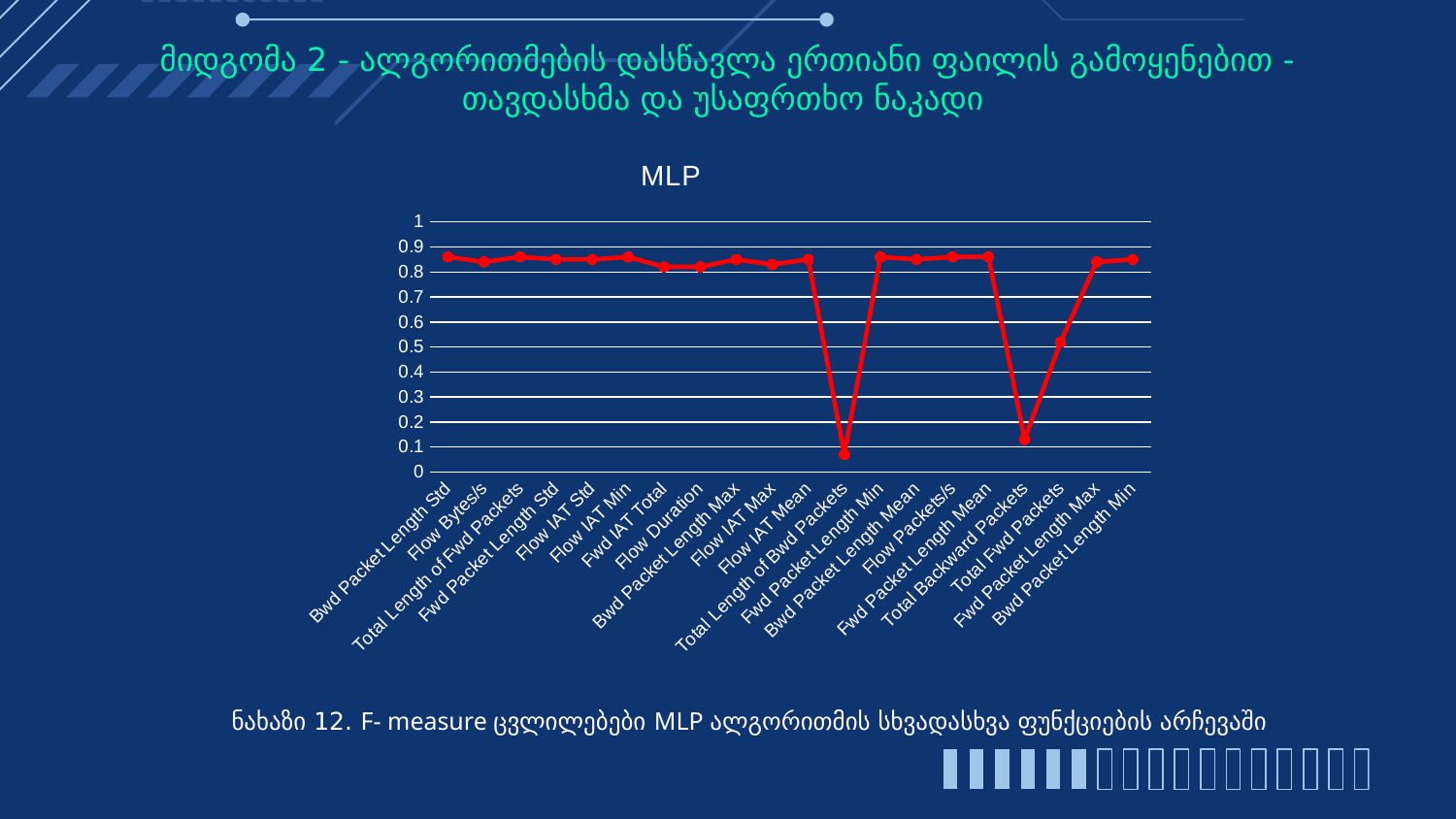
Is the value for Bwd Packet Length Std greater or less than 0.8? greater How many categories are plotted along the x axis of the MLP chart? 20 Which has a larger value, Flow IAT Mean or Total Length of Bwd Packets? Flow IAT Mean What is the title of the chart? MLP Is the value for Total Fwd Packets greater or less than 0.8? less Which has a larger value, Total Fwd Packets or Total Backward Packets? Total Fwd Packets What is the highest value shown on the y axis of the MLP chart? 1 Is the value for Flow IAT Mean greater or less than 0.8? greater What type of chart is shown on the slide? line chart